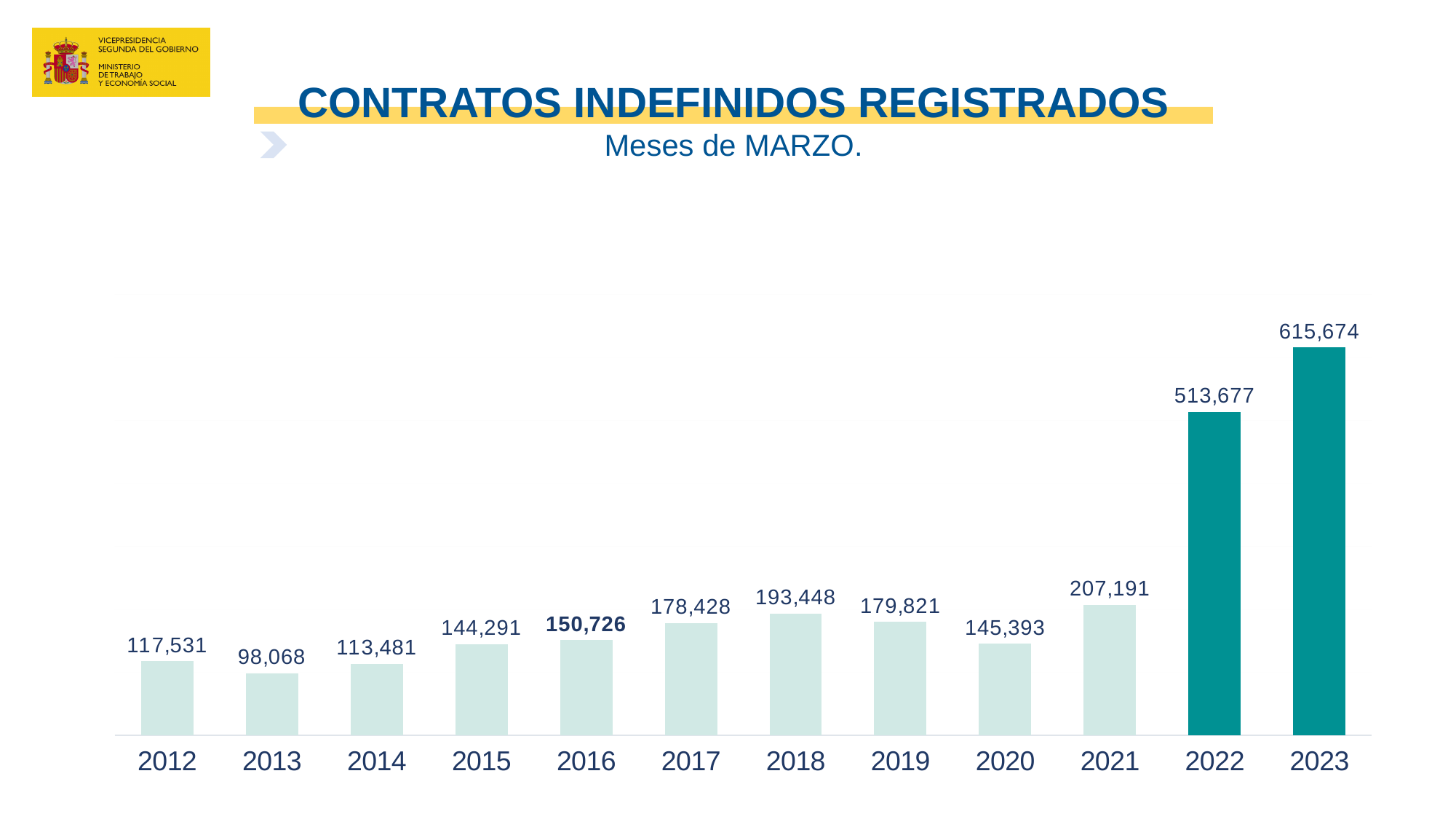
What is the title of the chart? CONTRATOS INDEFINIDOS REGISTRADOS What is the value for 2023? 615,674 How many years are shown on the x axis? 12 What kind of chart is shown on the slide? Bar chart What is the value for 2020? 145,393 Which year has the highest value? 2023 What is the value for 2016? 150,726 What is the difference between the values for 2023 and 2022? 101,997 What is the value for 2013? 98,068 Which year has the lowest value? 2013 What is the difference between the values for 2021 and 2020? 61,798 Which is larger, the value for 2018 or the value for 2019? 2018